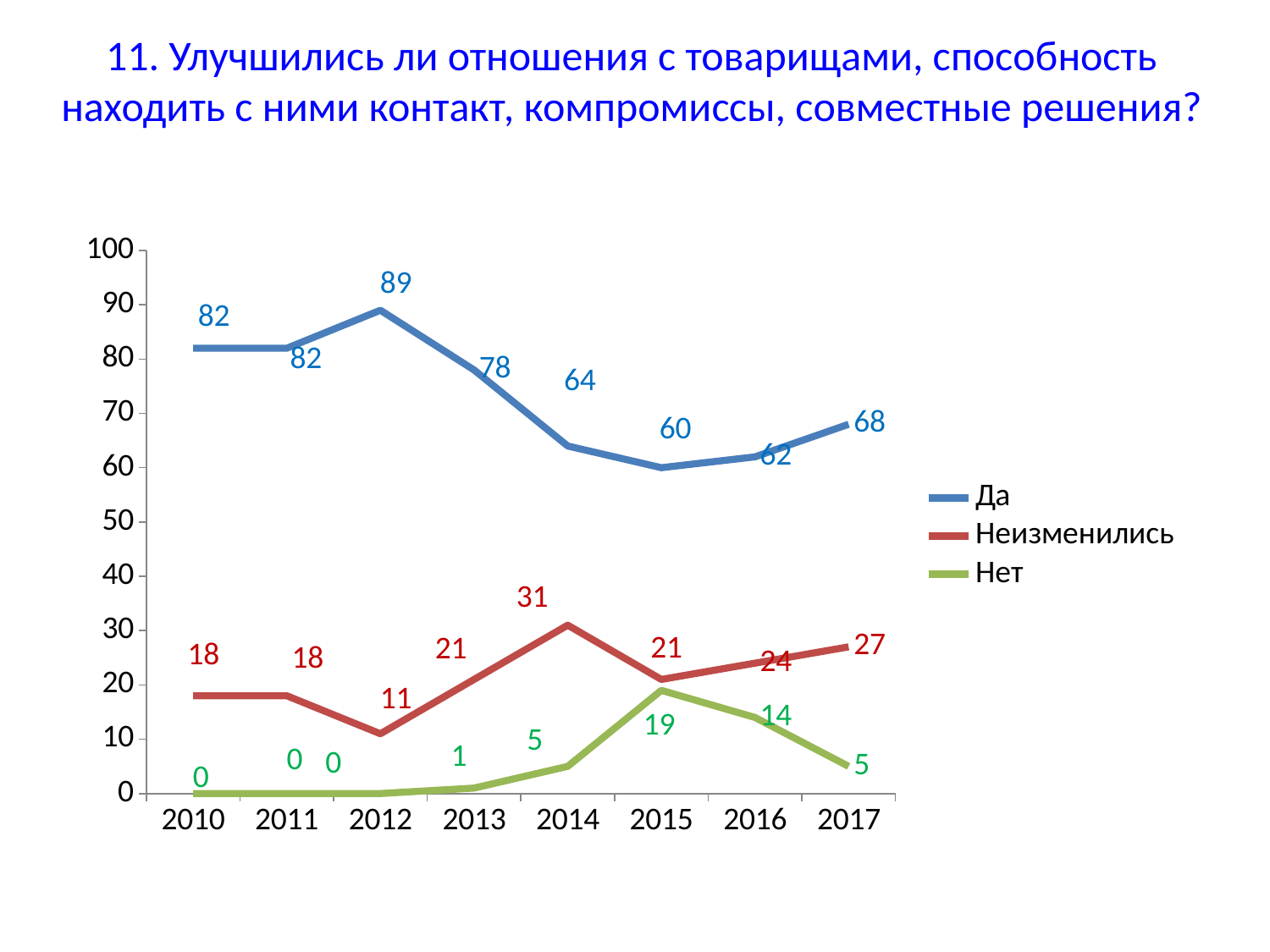
How many years are shown on the x axis? 8 Does the Да series rise or fall from 2012 to 2015? fall In which year is the Нет series at its highest? 2015 What is the value for Нет in 2015? 19 In which year is the Да series at its lowest? 2015 What is the difference between the Да values in 2012 and 2015? 29 How many series does the legend list? 3 What is the value for Да in 2012? 89 What type of chart is shown on the slide? line chart What is the value for Неизменились in 2014? 31 Which series is drawn in green in the legend? Нет Which is larger in 2016: the value for Неизменились or the value for Нет? Неизменились